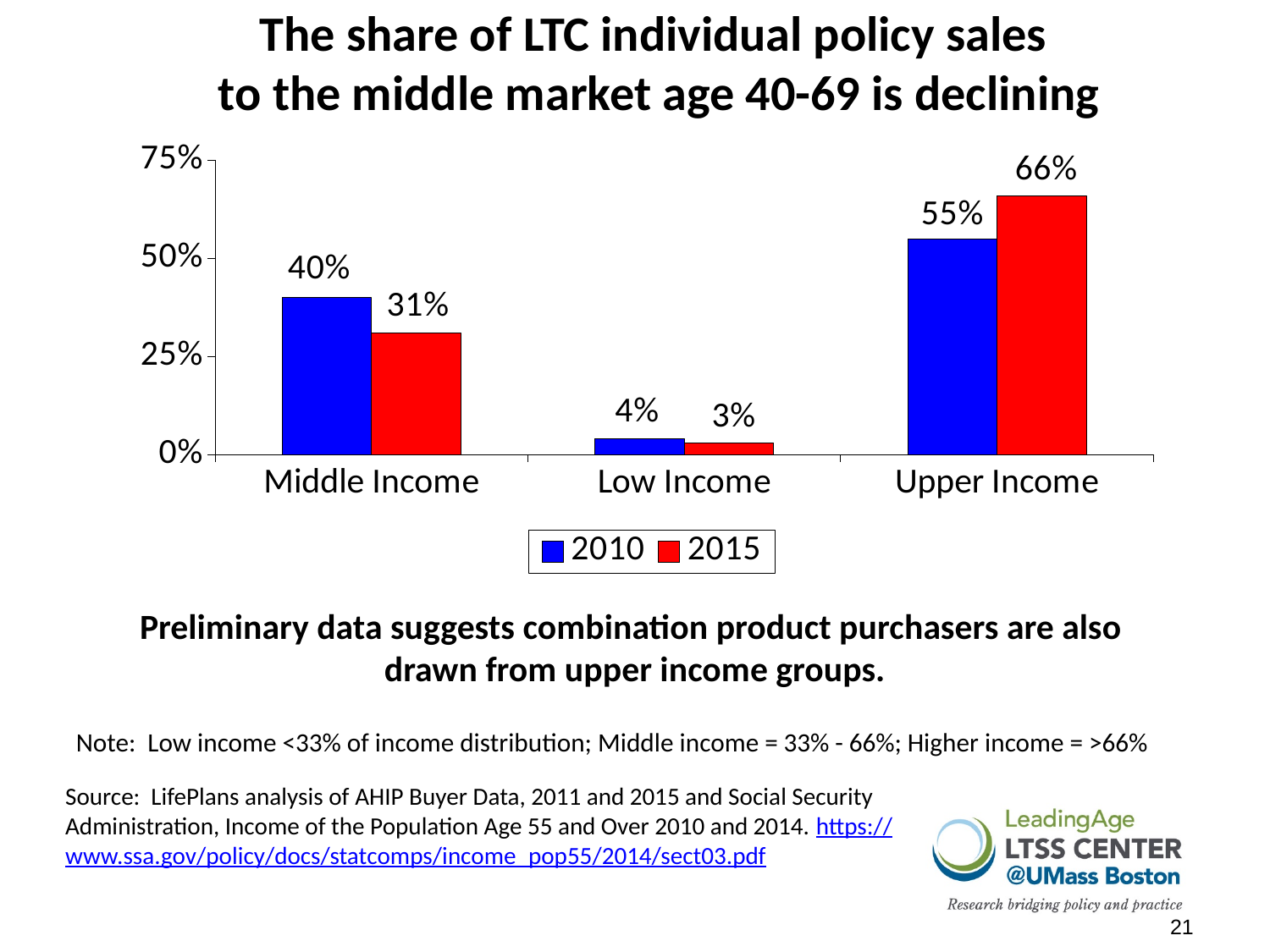
Which income group has the lowest value in 2010? Low Income What is the value for Upper Income in 2015? 66% What is the difference between the 2015 values for Upper Income and Middle Income? 35% How many income categories are shown on the x axis? 3 What kind of chart is shown on the slide? Bar chart What is the value for Low Income in 2015? 3% Which is larger for Upper Income: the 2010 value or the 2015 value? 2015 How many series does the legend list? 2 What is the difference between the 2010 and 2015 values for Middle Income? 9% Which colour represents the 2015 series in the legend? Red What is the value for Middle Income in 2010? 40% Which income group has the highest value in 2015? Upper Income